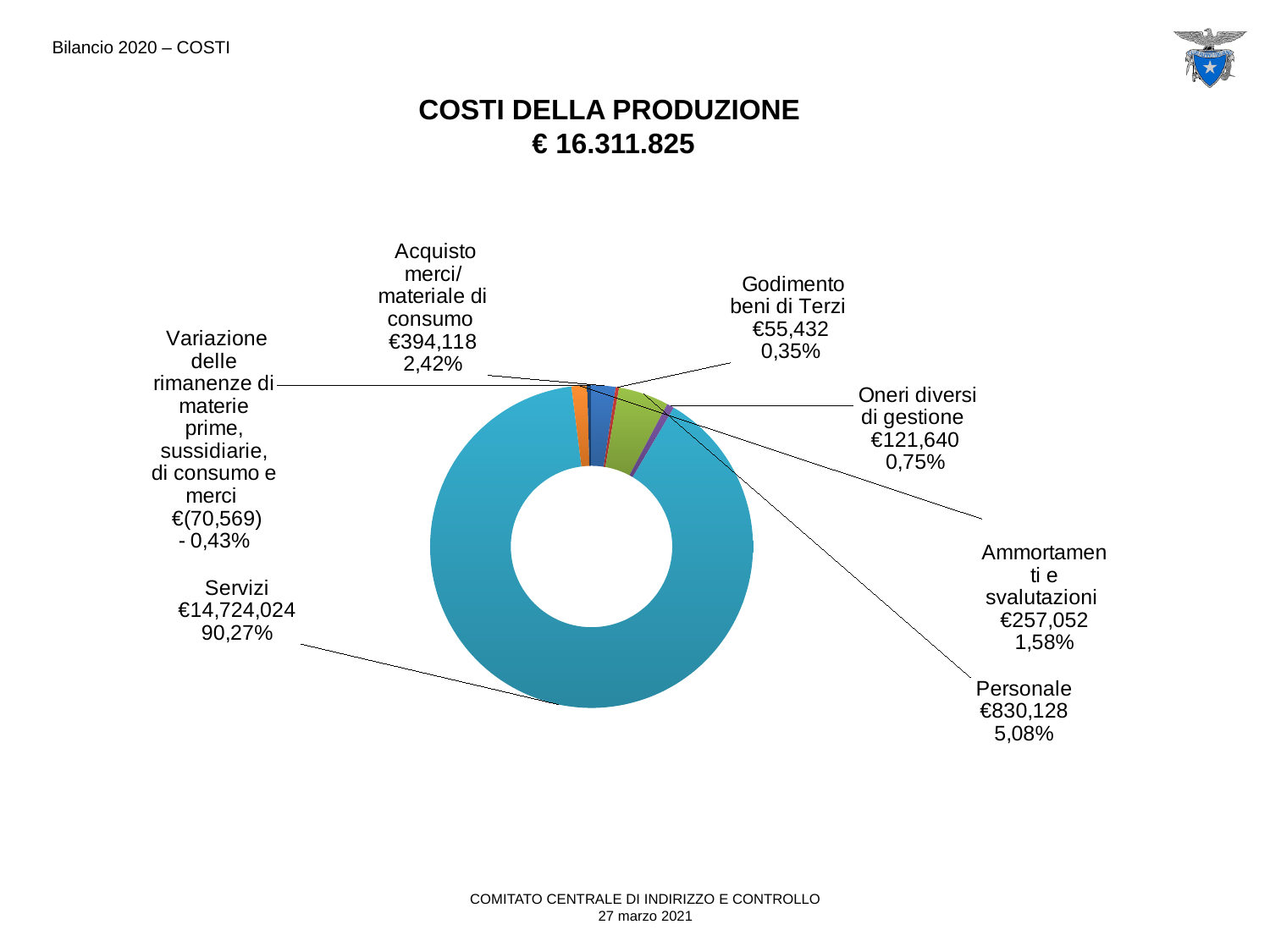
What is the difference in value between Personale and Ammortamenti e svalutazioni? €573,076 How many categories are shown in the chart? 7 What is the value for Servizi? €14,724,024 What percentage share does Personale have? 5,08% What kind of chart is shown on the slide? Doughnut (pie) chart Which category has the lowest value in the chart? Variazione delle rimanenze di materie prime, sussidiarie, di consumo e merci What is the title of the chart? COSTI DELLA PRODUZIONE € 16.311.825 What is the percentage share of Acquisto merci/materiale di consumo? 2,42% Which category has the largest share of the chart? Servizi What is the value for Ammortamenti e svalutazioni? €257,052 What is the total of the costi della produzione shown in the chart title? € 16.311.825 Which is larger, Oneri diversi di gestione or Godimento beni di Terzi? Oneri diversi di gestione